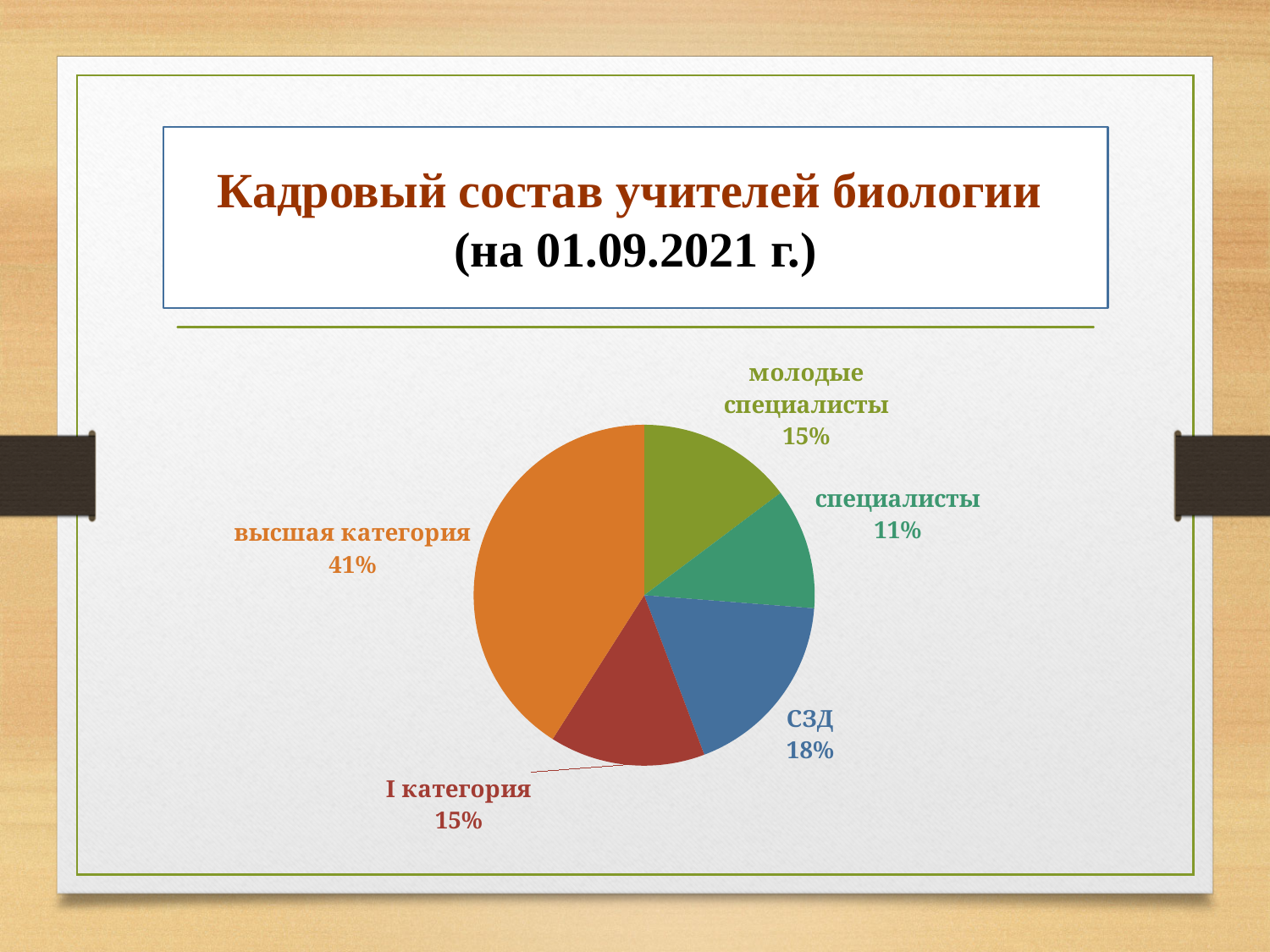
What share of the pie is labelled 'СЗД'? 18% What is the title of the slide containing the chart? Кадровый состав учителей биологии (на 01.09.2021 г.) Which is larger, the share for 'СЗД' or the share for 'специалисты'? СЗД What is the difference in percentage points between 'СЗД' and 'I категория'? 3 What share of the pie is labelled 'специалисты'? 11% Which category has the largest slice of the pie? высшая категория What share of the pie is labelled 'молодые специалисты'? 15% How many slices does the pie chart have? 5 What is the difference in percentage points between 'высшая категория' and 'СЗД'? 23 What kind of chart is shown on the slide? pie chart What share of the pie is labelled 'высшая категория'? 41% Which category has the smallest slice of the pie? специалисты